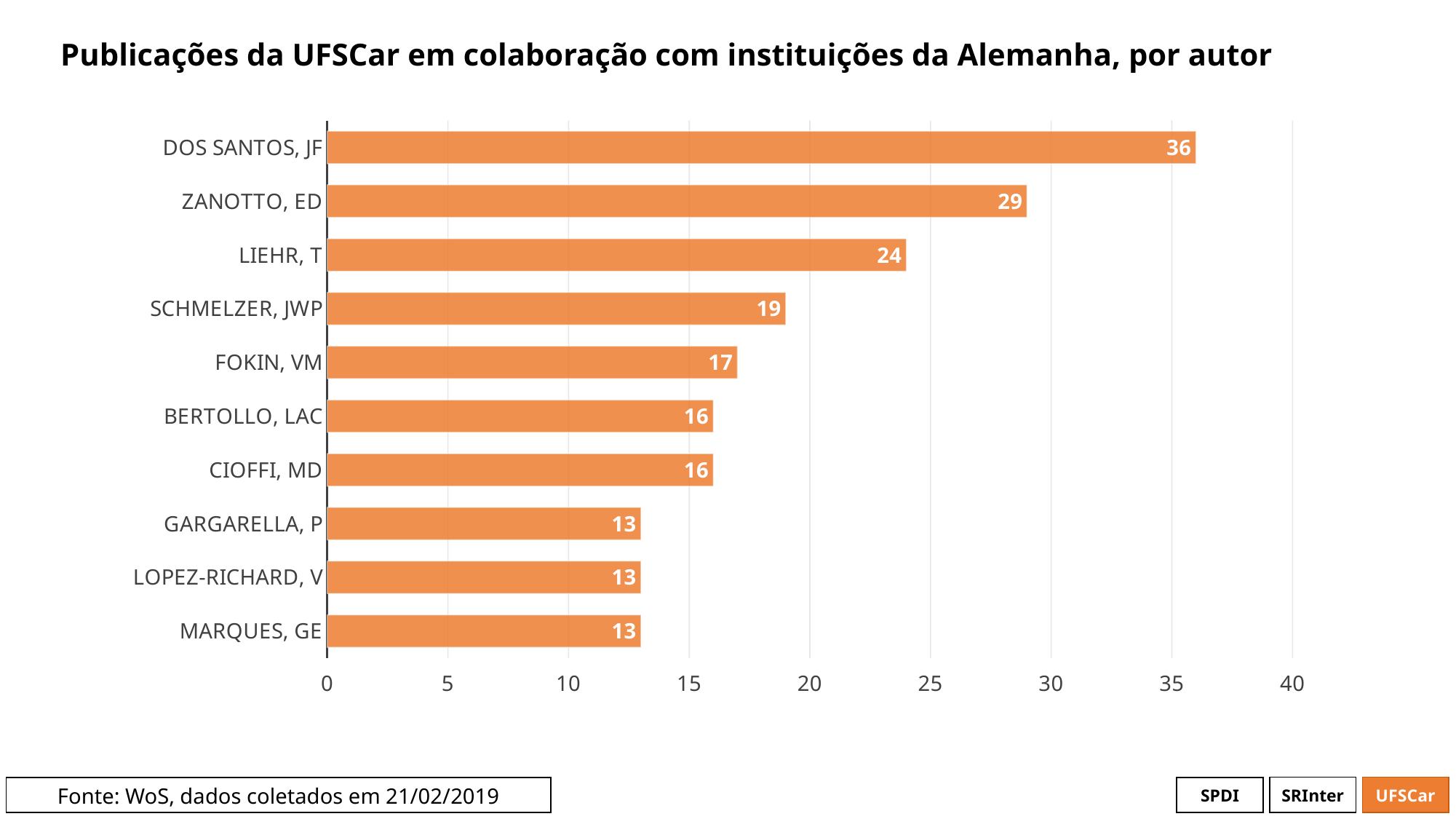
What is the title of the chart? Publicações da UFSCar em colaboração com instituições da Alemanha, por autor What is the value for LIEHR, T? 24 How many authors are shown in the chart? 10 How many authors have a value of 13? 3 What is the difference between the values for DOS SANTOS, JF and ZANOTTO, ED? 7 What kind of chart is shown on the slide? bar chart Which is larger, the value for ZANOTTO, ED or the value for LIEHR, T? ZANOTTO, ED How many publications does DOS SANTOS, JF have? 36 What is the value for FOKIN, VM? 17 Which author has the highest number of publications? DOS SANTOS, JF Is the value for BERTOLLO, LAC greater or less than 20? less What is the difference between the values for SCHMELZER, JWP and GARGARELLA, P? 6